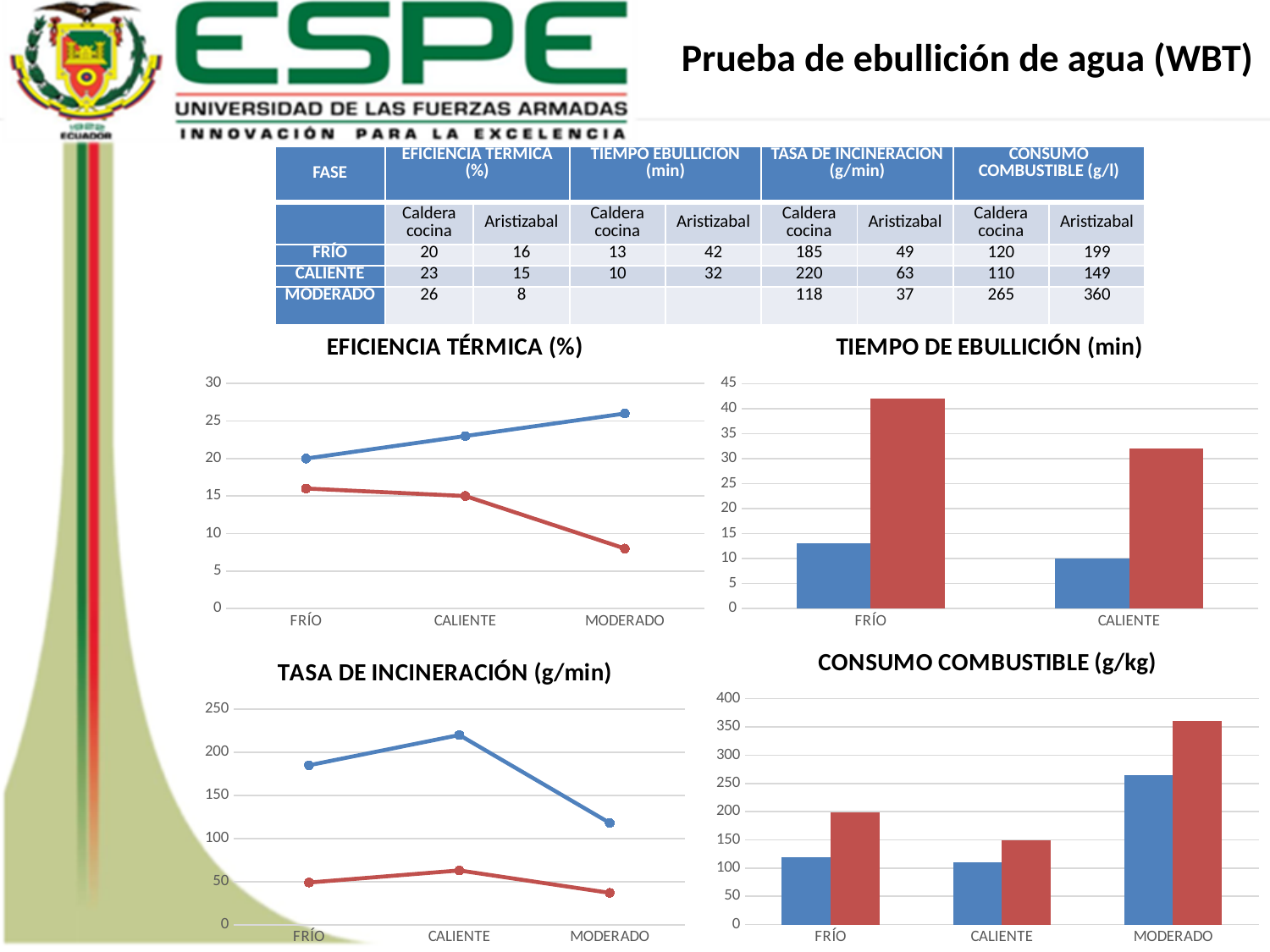
In the CONSUMO COMBUSTIBLE (g/kg) chart, which category has the tallest bar? MODERADO What kind of chart is the TIEMPO DE EBULLICIÓN (min) chart? bar chart How many categories are shown on the x axis of the CONSUMO COMBUSTIBLE (g/kg) chart? 3 In the EFICIENCIA TÉRMICA (%) chart, does the red line rise or fall from FRÍO to MODERADO? falls In the EFICIENCIA TÉRMICA (%) chart, what is the value of the blue line at FRÍO? 20 In the TIEMPO DE EBULLICIÓN (min) chart, which red bar is taller, FRÍO or CALIENTE? FRÍO In the EFICIENCIA TÉRMICA (%) chart, does the blue line rise or fall from FRÍO to MODERADO? rises In the TASA DE INCINERACIÓN (g/min) chart, at which category does the blue line reach its lowest point? MODERADO In the CONSUMO COMBUSTIBLE (g/kg) chart, is the blue bar for MODERADO greater or less than 250? greater How many categories are shown on the x axis of the TIEMPO DE EBULLICIÓN (min) chart? 2 In the TIEMPO DE EBULLICIÓN (min) chart, what is the value of the blue bar for CALIENTE? 10 What kind of chart is the EFICIENCIA TÉRMICA (%) chart? line chart